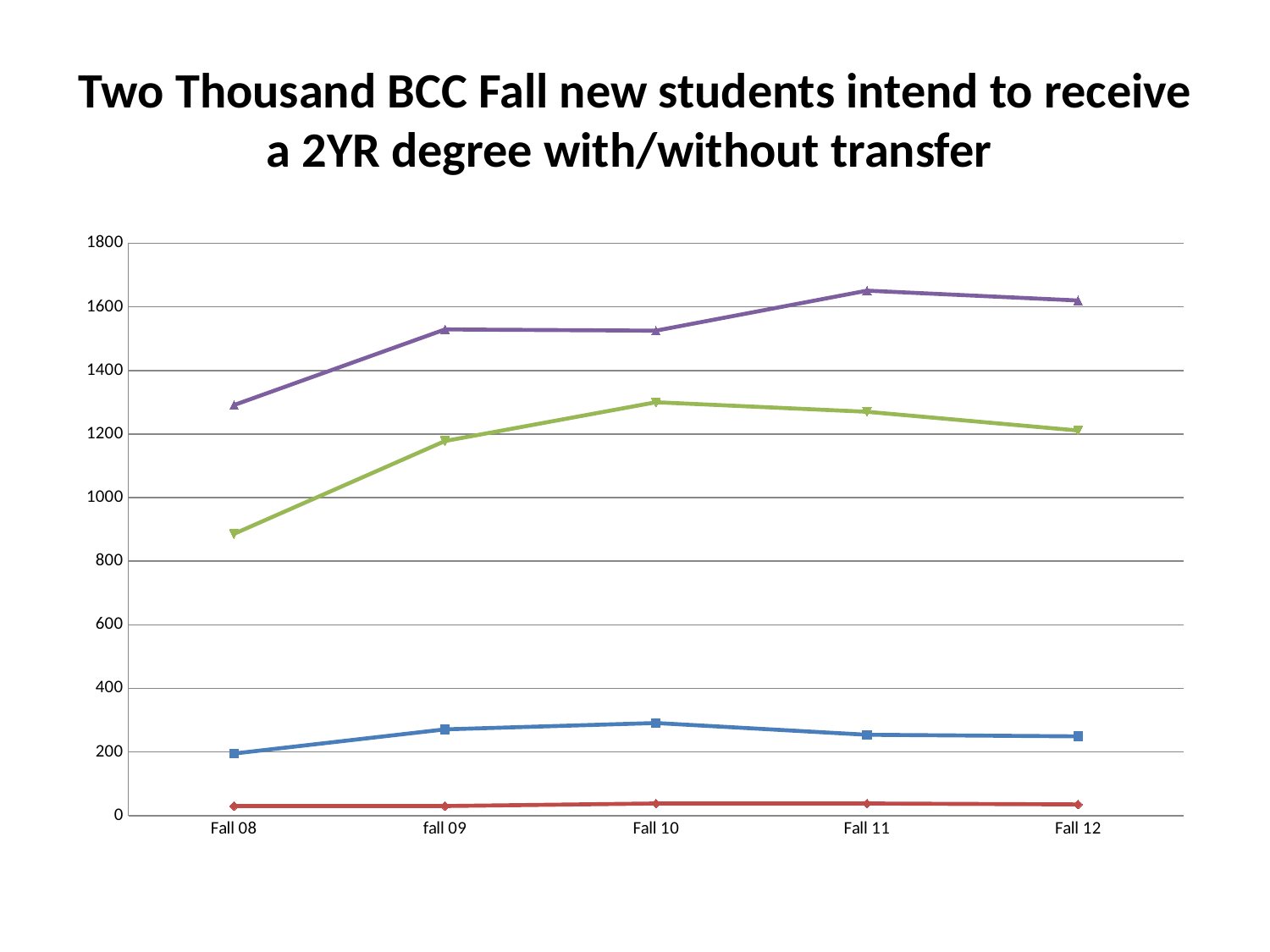
What kind of chart is shown on the slide? line chart How many points along the x axis does the chart have? 5 Is the value of the purple line at Fall 11 greater or less than 1600? greater At which x-axis point is the green line lowest? Fall 08 How many lines are plotted on the chart? 4 Is the value of the green line at Fall 10 greater or less than 1200? greater Which line is higher at Fall 12, the purple line or the green line? purple line Is the value of the red line at Fall 12 greater or less than 200? less At which x-axis point does the purple line reach its highest value? Fall 11